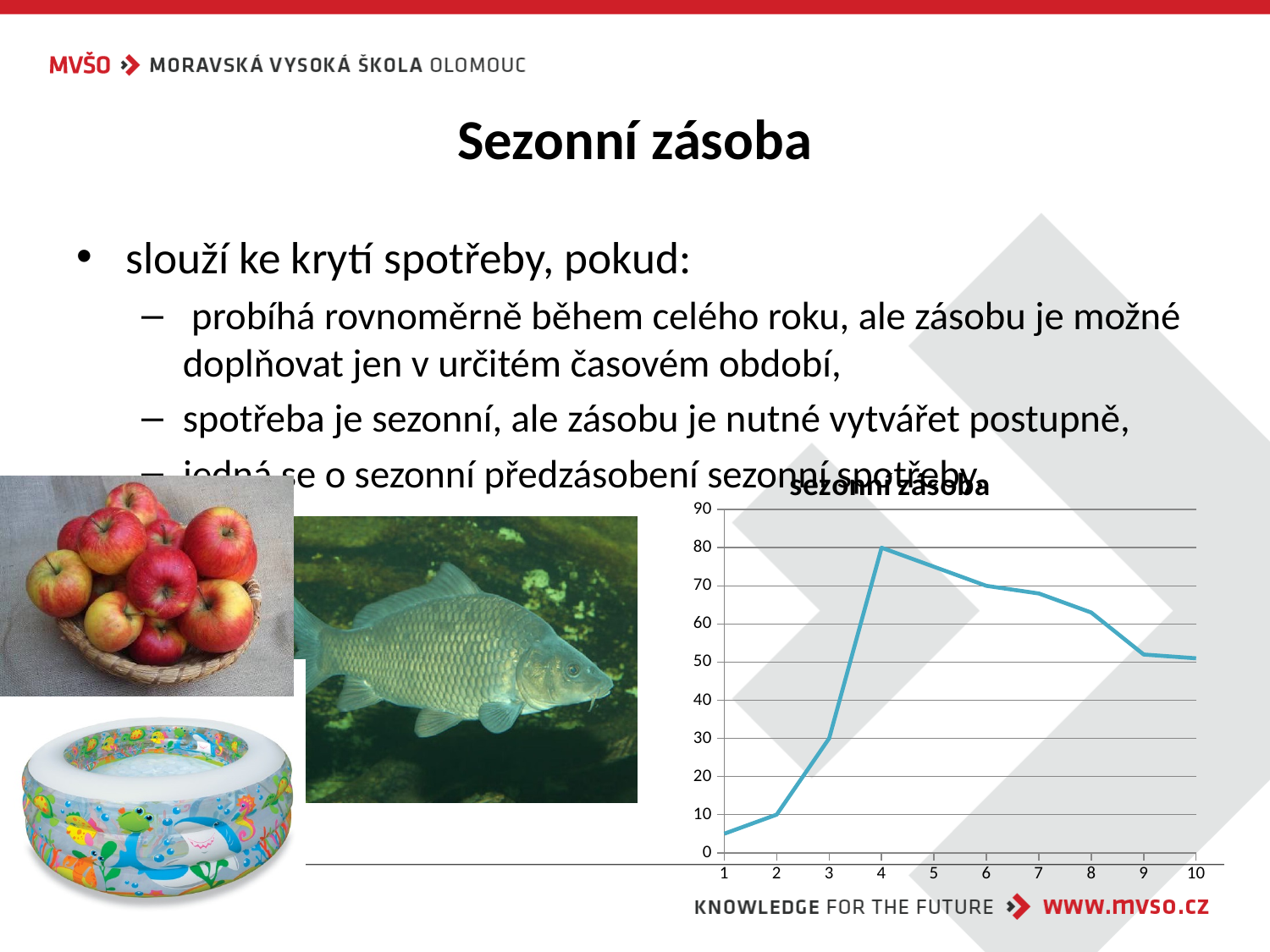
What is the title of the chart? sezonní zásoba At which x-axis point does the line reach its highest value? 4 What is the value at point 2? 10 Is the value at point 5 greater or less than 70? greater Is the value at point 1 greater or less than 10? less Is the value at point 9 greater or less than 60? less How many points are plotted on the x axis of the chart? 10 At which x-axis point does the line have its lowest value? 1 Do the values rise or fall from point 4 to point 10? fall What kind of chart is shown on the slide? line chart Which has the larger value, point 3 or point 8? point 8 What is the value at point 4? 80